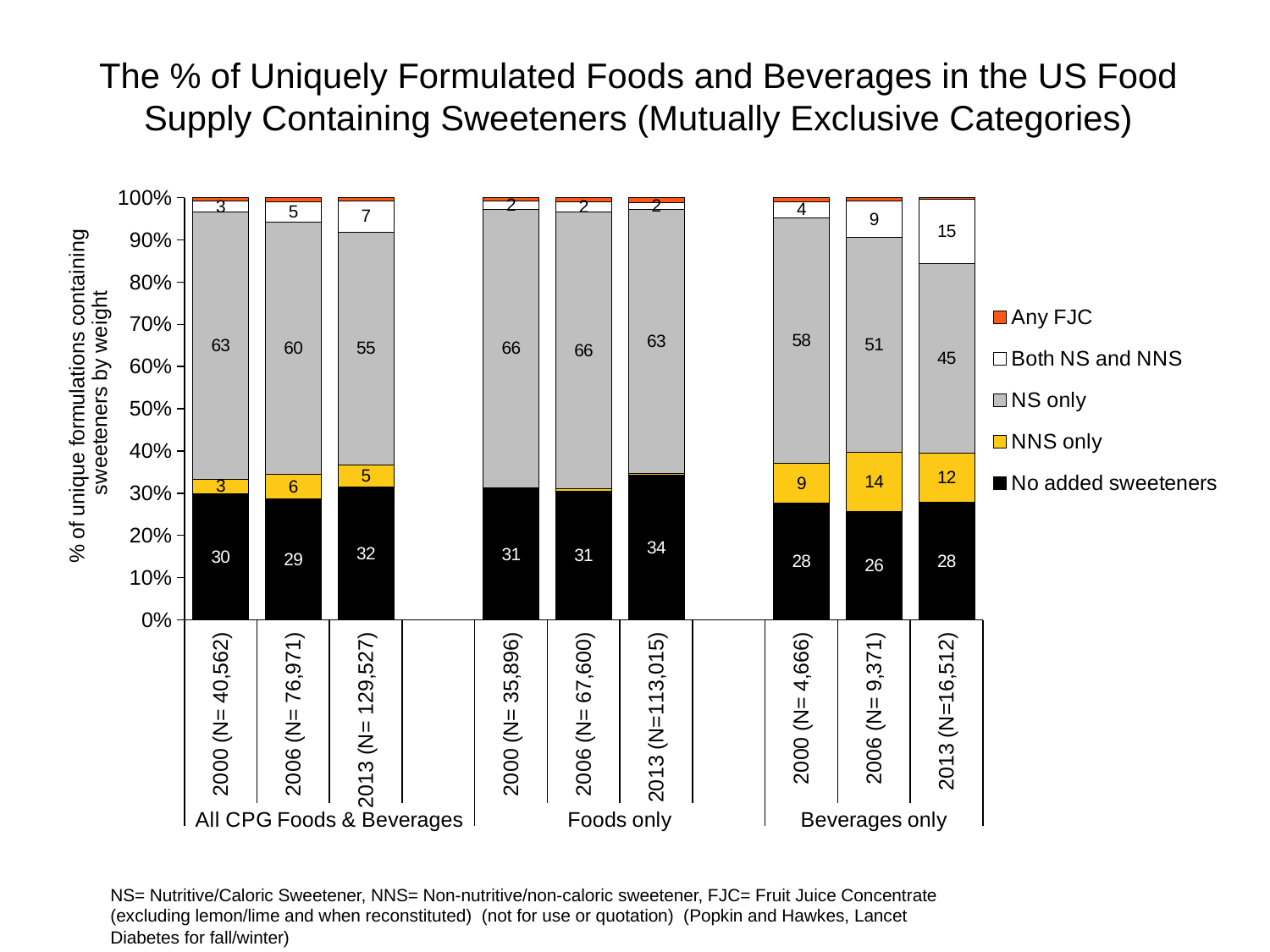
What is the value of the NS only segment for 2013 (N=16,512) in the Beverages only group? 45 Which bar has the highest NNS only value? 2006 (N= 9,371), Beverages only What kind of chart is shown on the slide? Stacked bar chart In the Beverages only group, does the NS only value rise or fall from 2000 to 2013? Fall What is the value of the Both NS and NNS segment for 2013 (N=16,512) in the Beverages only group? 15 Which bar has the lowest No added sweeteners value? 2006 (N= 9,371), Beverages only In the All CPG Foods & Beverages group, what is the difference between the NS only value for 2000 and for 2013? 8 Which is larger: the NS only value for 2000 in Foods only or the NS only value for 2000 in Beverages only? 2000 in Foods only How many bars are plotted in the chart? 9 Which series is shown in black in the legend? No added sweeteners What is the value of the No added sweeteners segment for 2006 (N= 67,600) in the Foods only group? 31 How many series does the legend list? 5